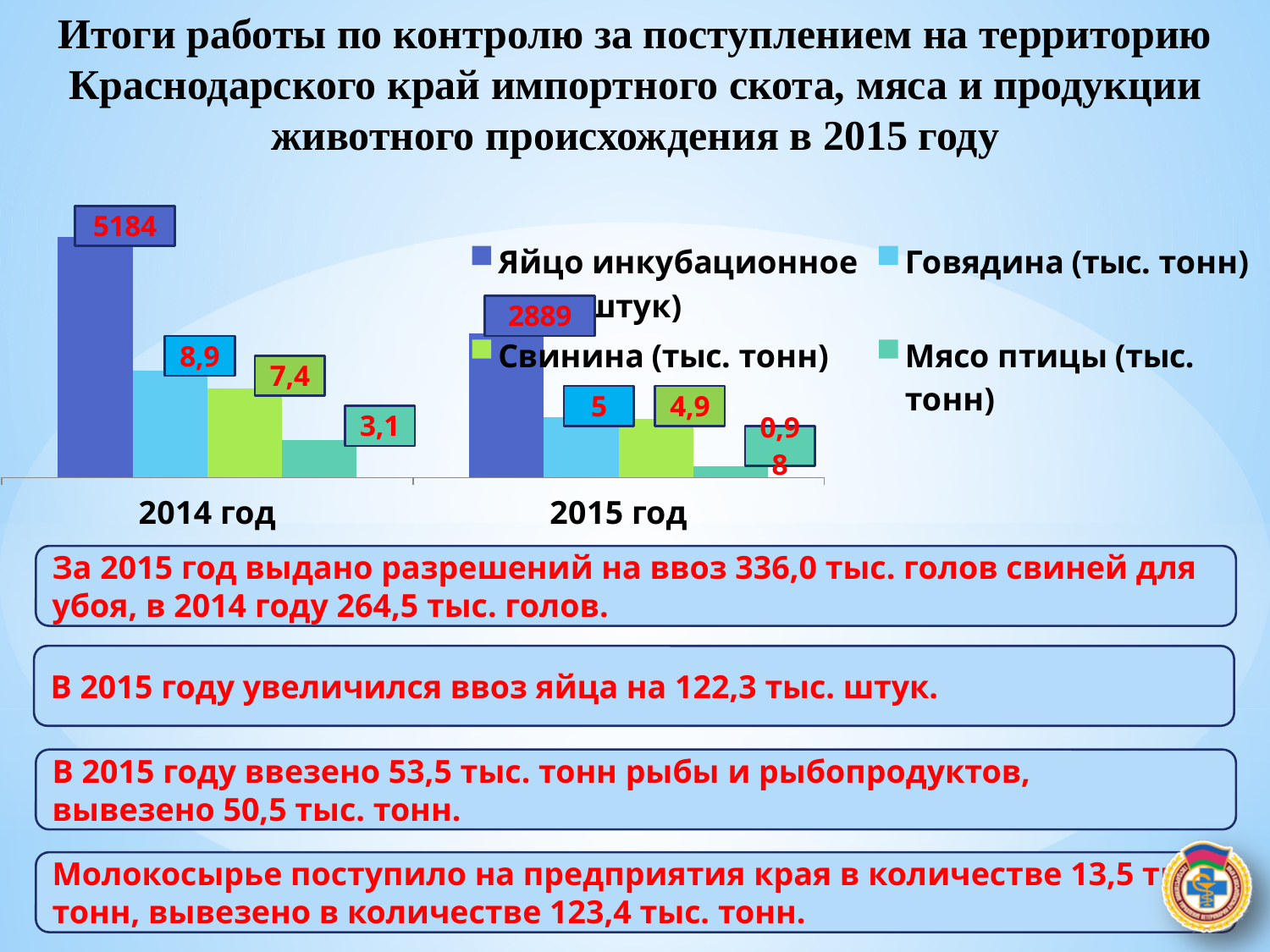
What is the value for Свинина (тыс. тонн) in 2015 год? 4,9 How many categories are shown on the x axis? 2 By how much did the value for Говядина (тыс. тонн) decrease from 2014 год to 2015 год? 3,9 What is the value for Говядина (тыс. тонн) in 2015 год? 5 What is the value for Мясо птицы (тыс. тонн) in 2014 год? 3,1 Which year has the larger value for Свинина (тыс. тонн), 2014 год or 2015 год? 2014 год How many series does the legend list? 4 What is the value for Яйцо инкубационное in 2014 год? 5184 What kind of chart is shown on the slide? bar chart What is the value for Яйцо инкубационное in 2015 год? 2889 What is the value for Говядина (тыс. тонн) in 2014 год? 8,9 What is the difference between the Яйцо инкубационное values for 2014 год and 2015 год? 2295